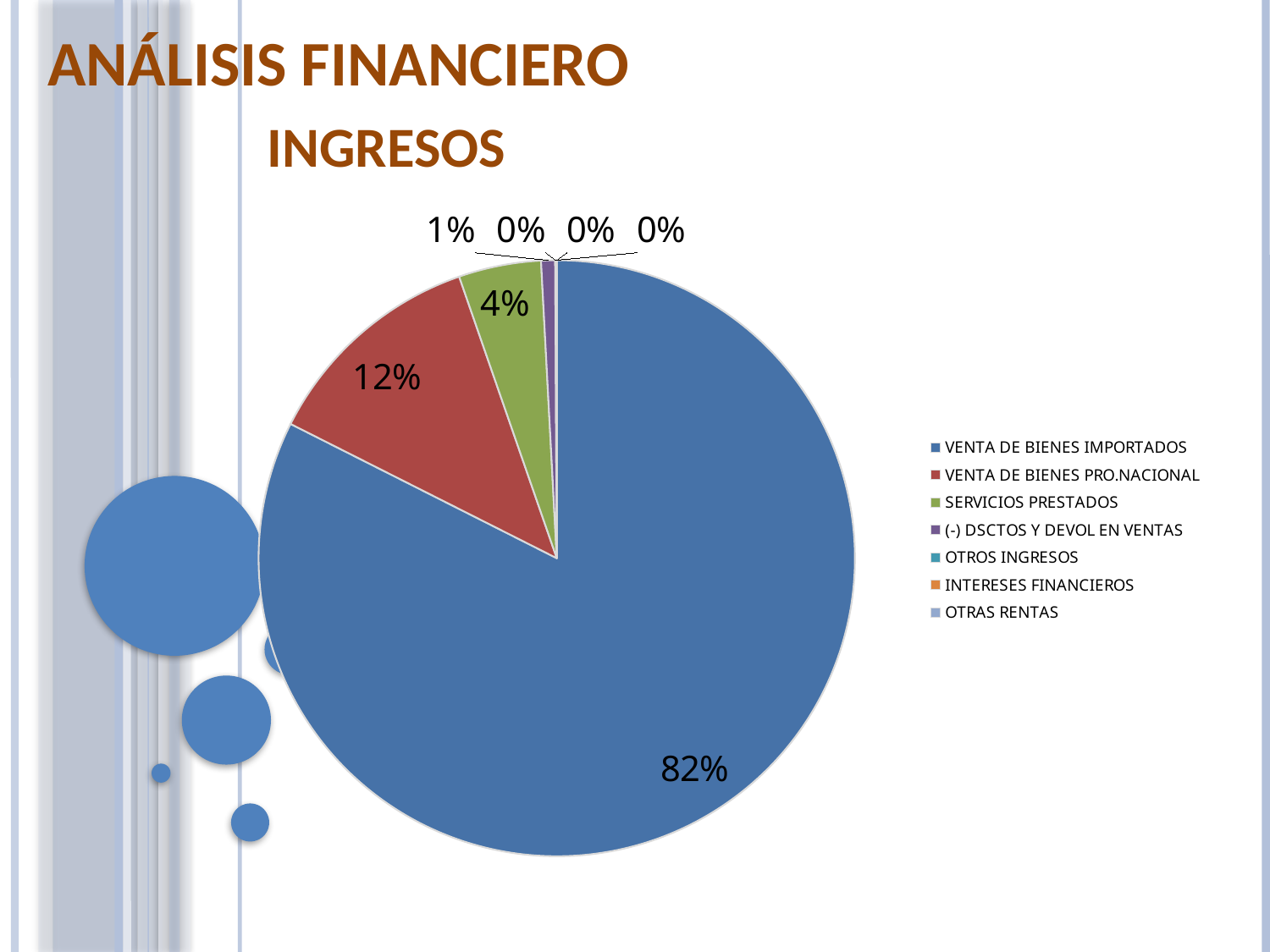
Which category has the largest slice of the pie? VENTA DE BIENES IMPORTADOS What share of the pie does SERVICIOS PRESTADOS represent? 4% What share of the pie does VENTA DE BIENES PRO.NACIONAL represent? 12% What share of the pie does OTROS INGRESOS represent? 0% What colour is the slice for SERVICIOS PRESTADOS? green What is the title of the chart? INGRESOS How many categories does the legend of the pie chart list? 7 Which is larger, the slice for VENTA DE BIENES PRO.NACIONAL or the slice for SERVICIOS PRESTADOS? VENTA DE BIENES PRO.NACIONAL What kind of chart is shown on the slide? pie chart What is the difference in percentage points between the VENTA DE BIENES IMPORTADOS slice and the VENTA DE BIENES PRO.NACIONAL slice? 70 percentage points